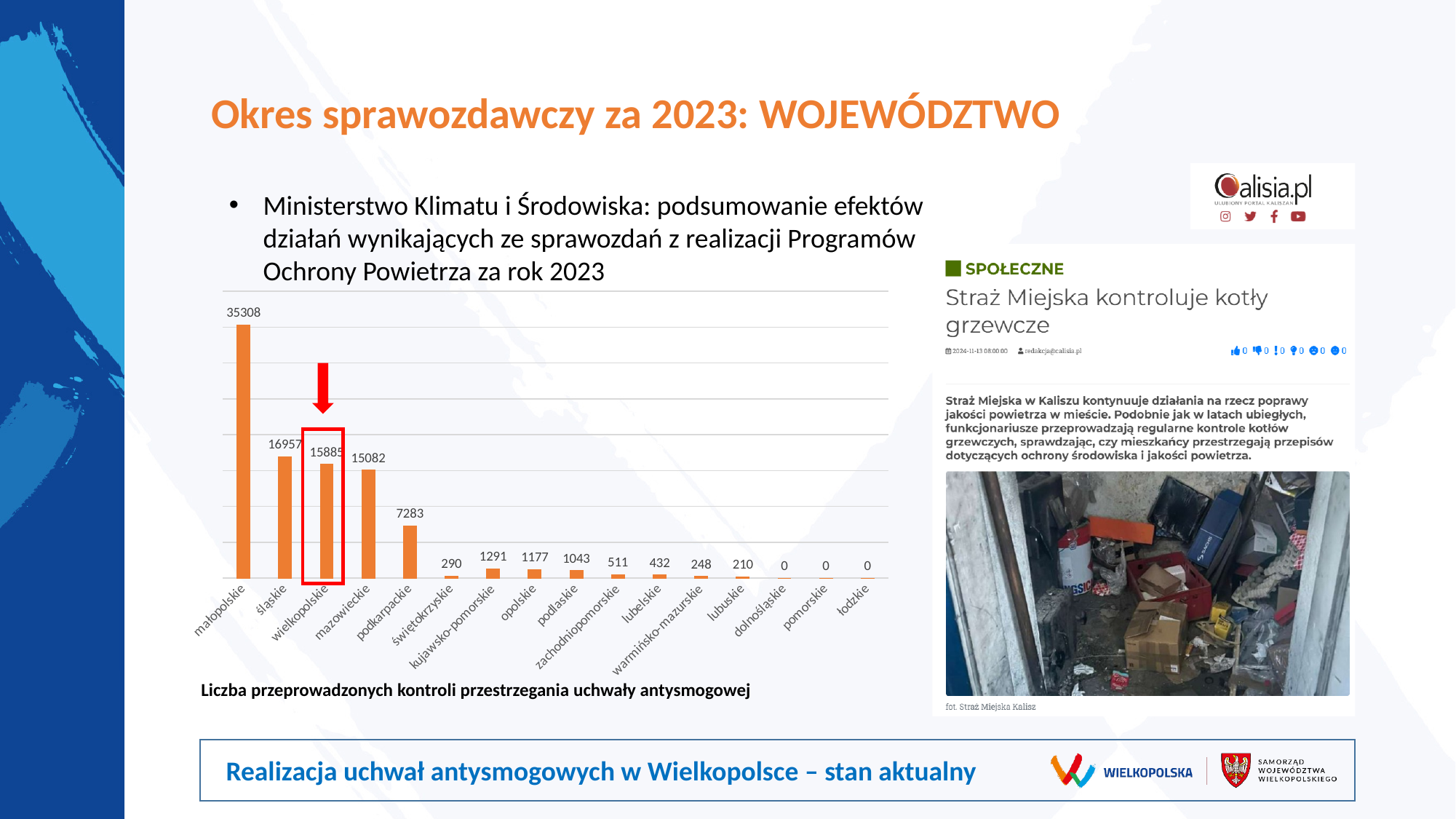
What is the value for małopolskie in the chart? 35308 What kind of chart is shown on the slide? bar chart What is the value for podkarpackie in the chart? 7283 What is the value for kujawsko-pomorskie in the chart? 1291 What is the difference between the values for małopolskie and mazowieckie? 20226 What is the value for wielkopolskie in the chart? 15885 What is the difference between the values for śląskie and wielkopolskie? 1072 How many categories in the chart have a value of 0? 3 Which voivodeship has the highest value in the chart? małopolskie How many categories are shown on the x axis of the chart? 16 Which bar in the chart is outlined with a red box and marked with a red arrow? wielkopolskie Which is larger, the value for opolskie or the value for podlaskie? opolskie